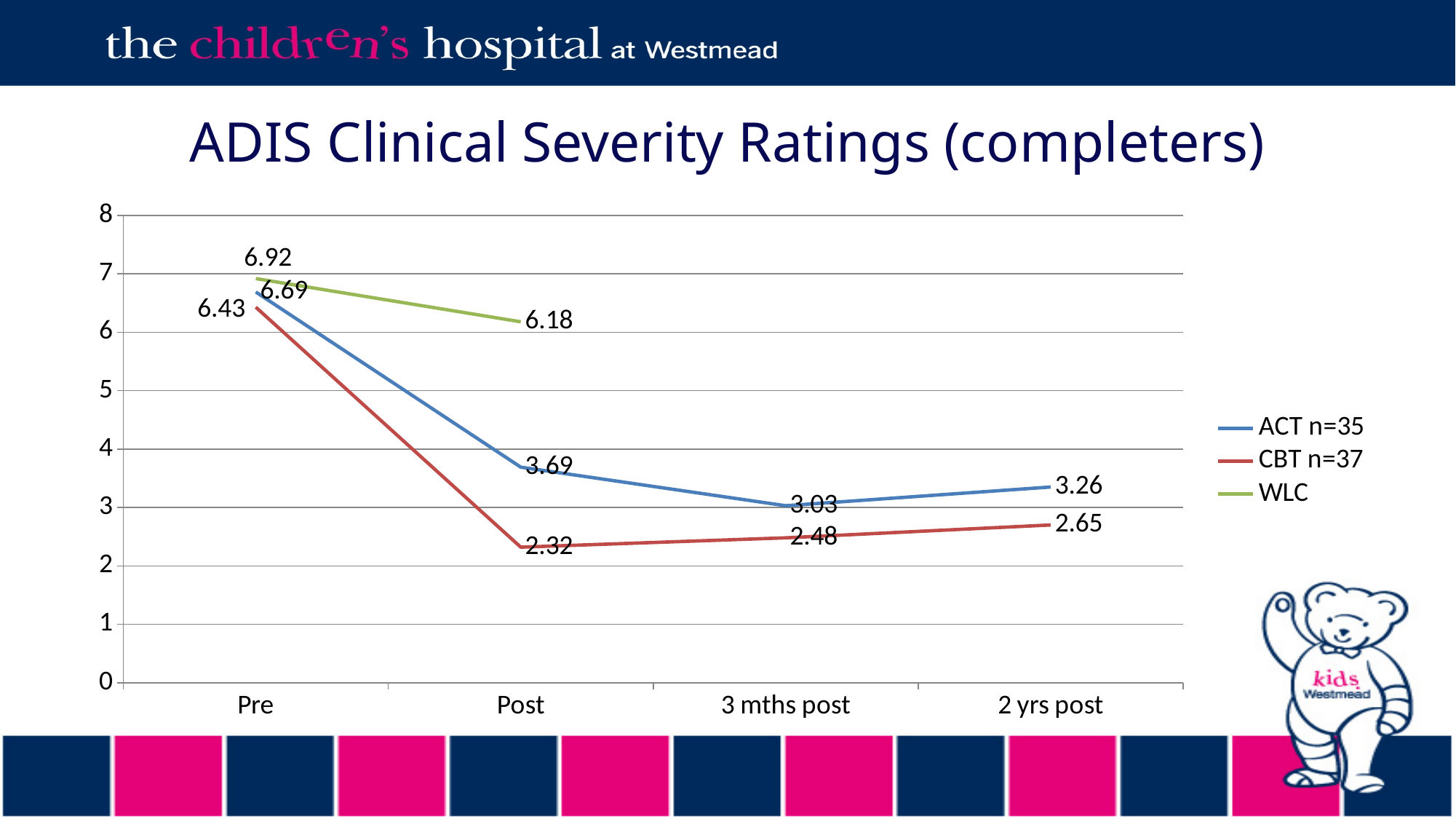
What is the CBT n=37 value at 3 mths post? 2.48 Which is larger at 3 mths post, ACT n=35 or CBT n=37? ACT n=35 What kind of chart is shown on the slide? line chart What is the CBT n=37 value at 2 yrs post? 2.65 Which series has the lowest value at Pre? CBT n=37 How many time points are shown on the x axis? 4 What is the difference between the ACT n=35 and CBT n=37 values at Post? 1.37 What is the WLC value at Pre? 6.92 Which series has the highest value at Post? WLC What is the ACT n=35 value at Post? 3.69 How many series does the legend list? 3 Does the CBT n=37 line rise or fall from Pre to Post? fall